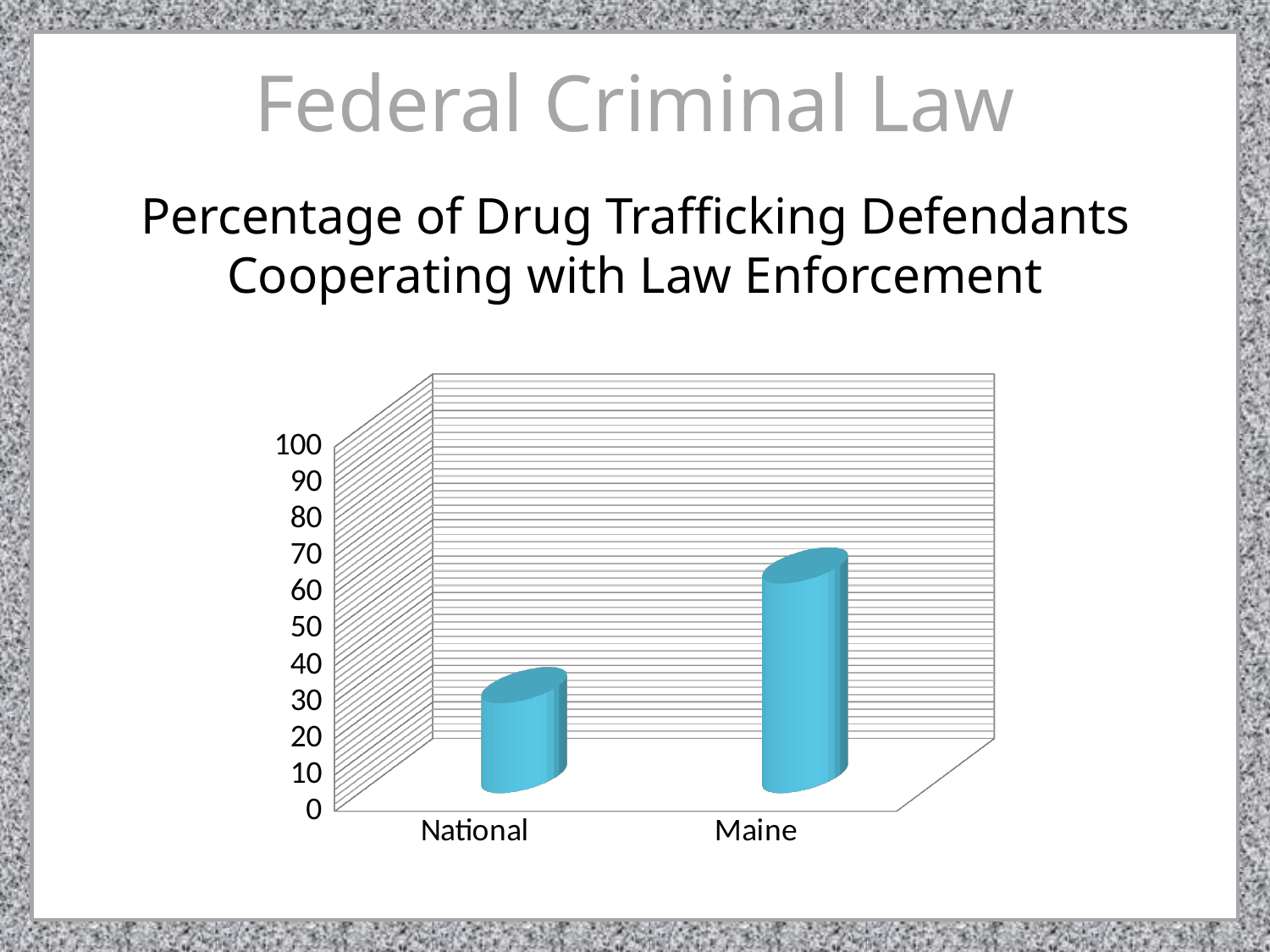
Which category has the lowest value on the chart? National Which category has the higher value, National or Maine? Maine What kind of chart is shown on the slide? bar chart Which category has the highest value on the chart? Maine Is the value for National greater or less than 40? less Is the value for National greater or less than 10? greater How many categories are shown on the chart? 2 What is the maximum value shown on the vertical axis? 100 Is the value for Maine greater or less than 80? less What is the title of the chart on the slide? Percentage of Drug Trafficking Defendants Cooperating with Law Enforcement